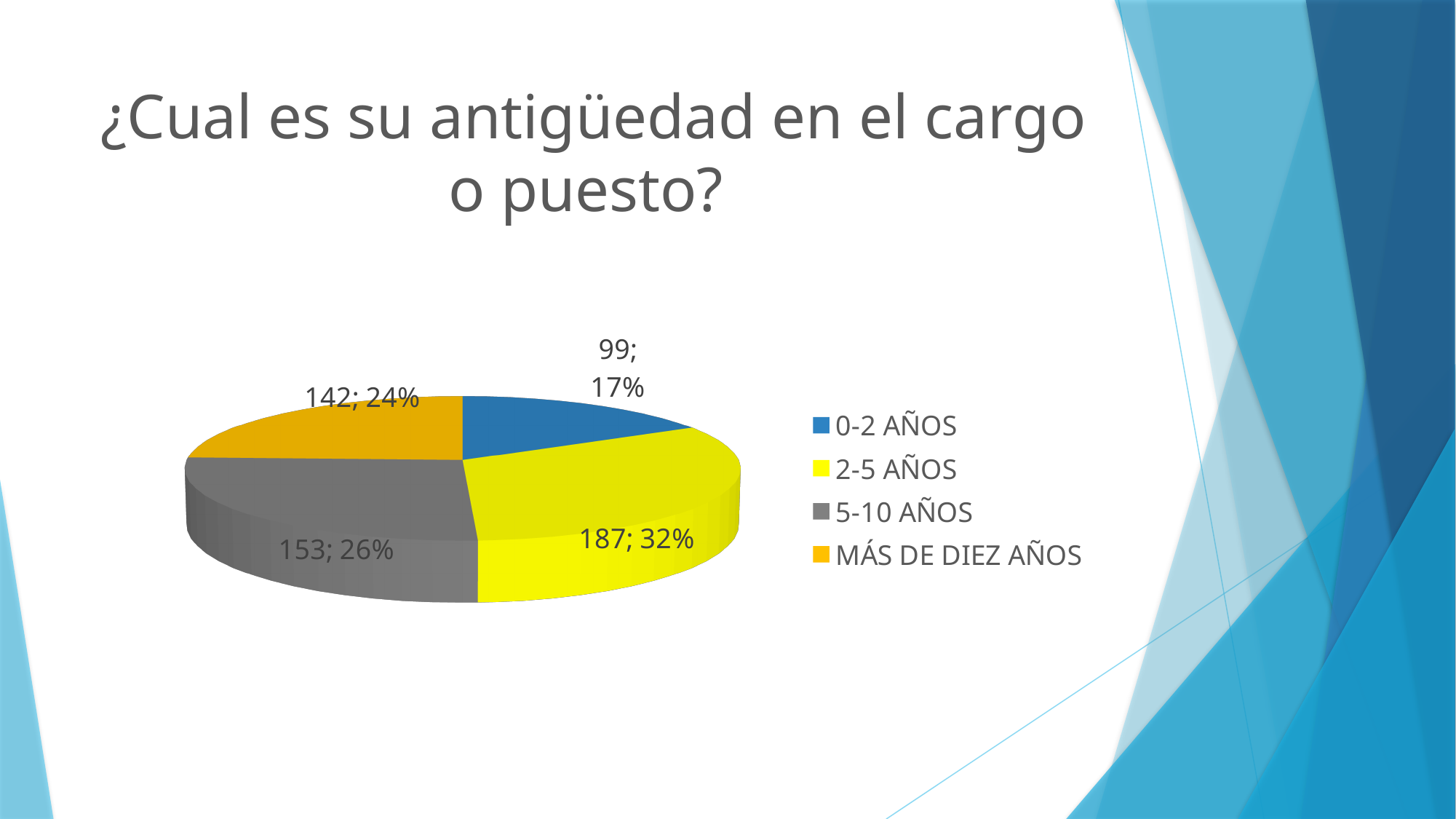
Which category has the largest slice? 2-5 AÑOS What percentage share does 5-10 AÑOS have? 26% What is the difference between the values for 5-10 AÑOS and MÁS DE DIEZ AÑOS? 11 How many categories does the pie chart have? 4 What is the value for MÁS DE DIEZ AÑOS? 142 What is the value for 0-2 AÑOS? 99 What percentage share does 2-5 AÑOS have? 32% What colour is the slice for MÁS DE DIEZ AÑOS? Orange Which category has the smallest slice? 0-2 AÑOS Which is larger, the value for 5-10 AÑOS or the value for 0-2 AÑOS? 5-10 AÑOS What kind of chart is shown on the slide? Pie chart What is the value for 2-5 AÑOS? 187